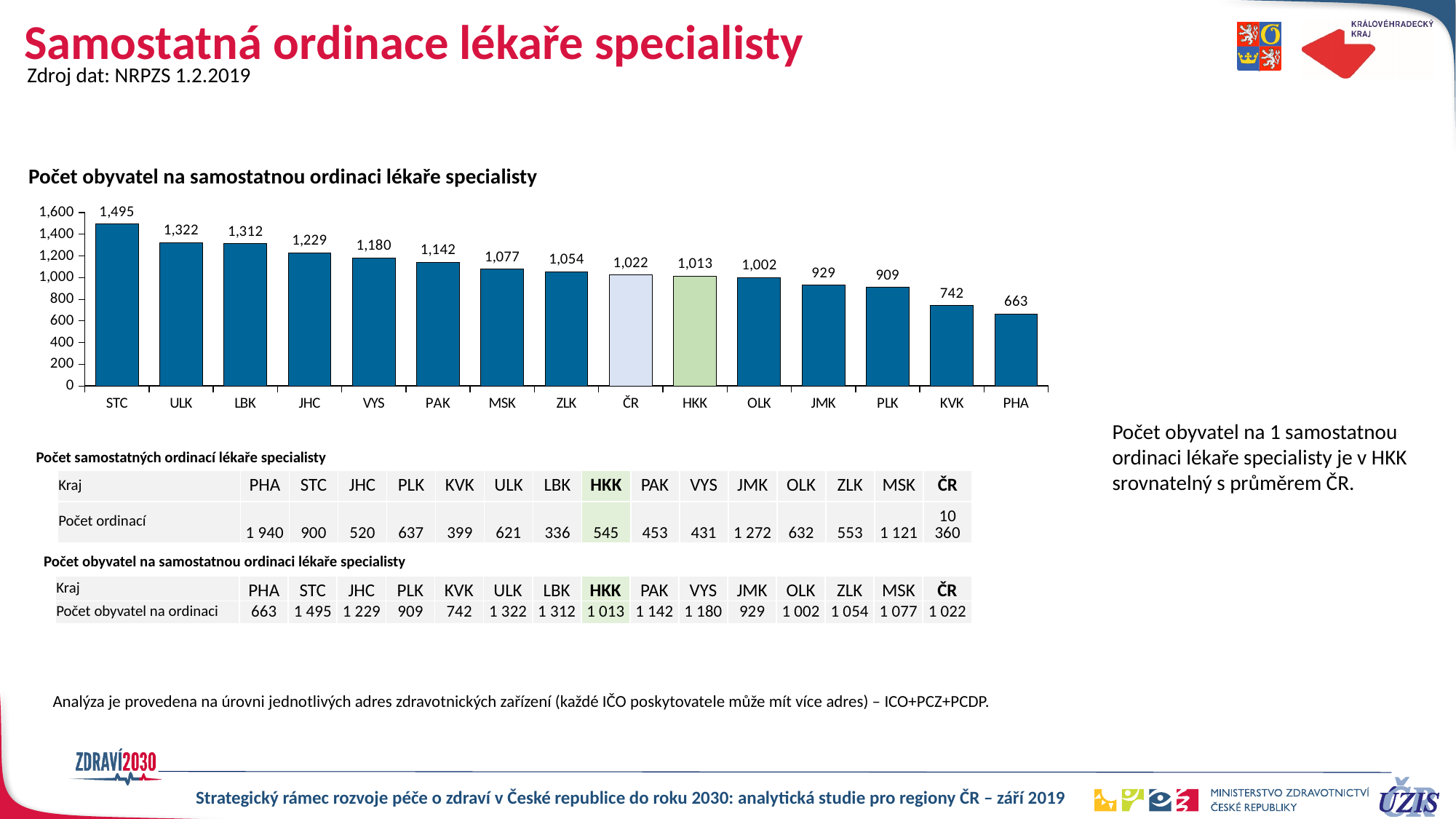
What is the difference between the values for ČR and HKK in the bar chart? 9 Which has a larger value in the bar chart, ULK or KVK? ULK What is the value for STC in the bar chart? 1,495 What is the value for HKK in the bar chart? 1,013 How many categories are shown on the x axis of the bar chart? 15 What is the value for ČR in the bar chart? 1,022 Which category has the lowest value in the bar chart? PHA Which category has the highest value in the bar chart? STC What is the title of the chart on the slide? Počet obyvatel na samostatnou ordinaci lékaře specialisty What kind of chart is shown on the slide? bar chart What is the difference between the values for STC and PHA in the bar chart? 832 What is the value for PHA in the bar chart? 663